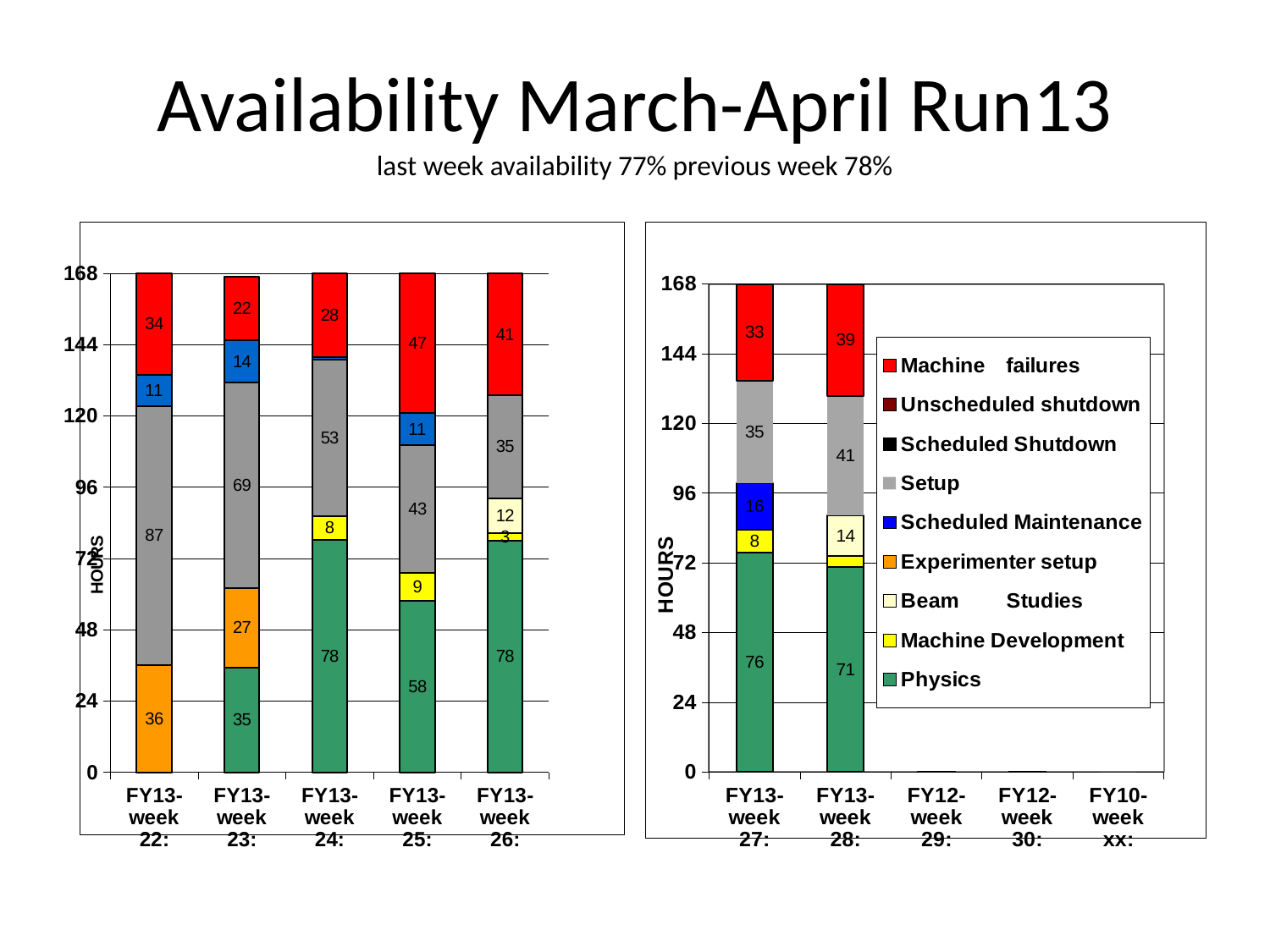
In the right chart, what is the Physics value for FY13-week 27? 76 How many series does the legend on the right chart list? 9 In the left chart, which is larger: the Physics value for FY13-week 23 or for FY13-week 25? FY13-week 25 What kind of chart is the left chart? Stacked bar chart In the right chart, what is the Machine failures value for FY13-week 28? 39 In the left chart, which week has the highest Setup value? FY13-week 22 In the left chart, what is the Machine failures value for FY13-week 25? 47 In the left chart, what is the Physics value for FY13-week 24? 78 In the left chart, what is the Setup value for FY13-week 22? 87 In the right chart, what is the difference between the Setup values for FY13-week 28 and FY13-week 27? 6 What is the y-axis title of the right chart? HOURS In the left chart, which week has the highest Machine failures value? FY13-week 25